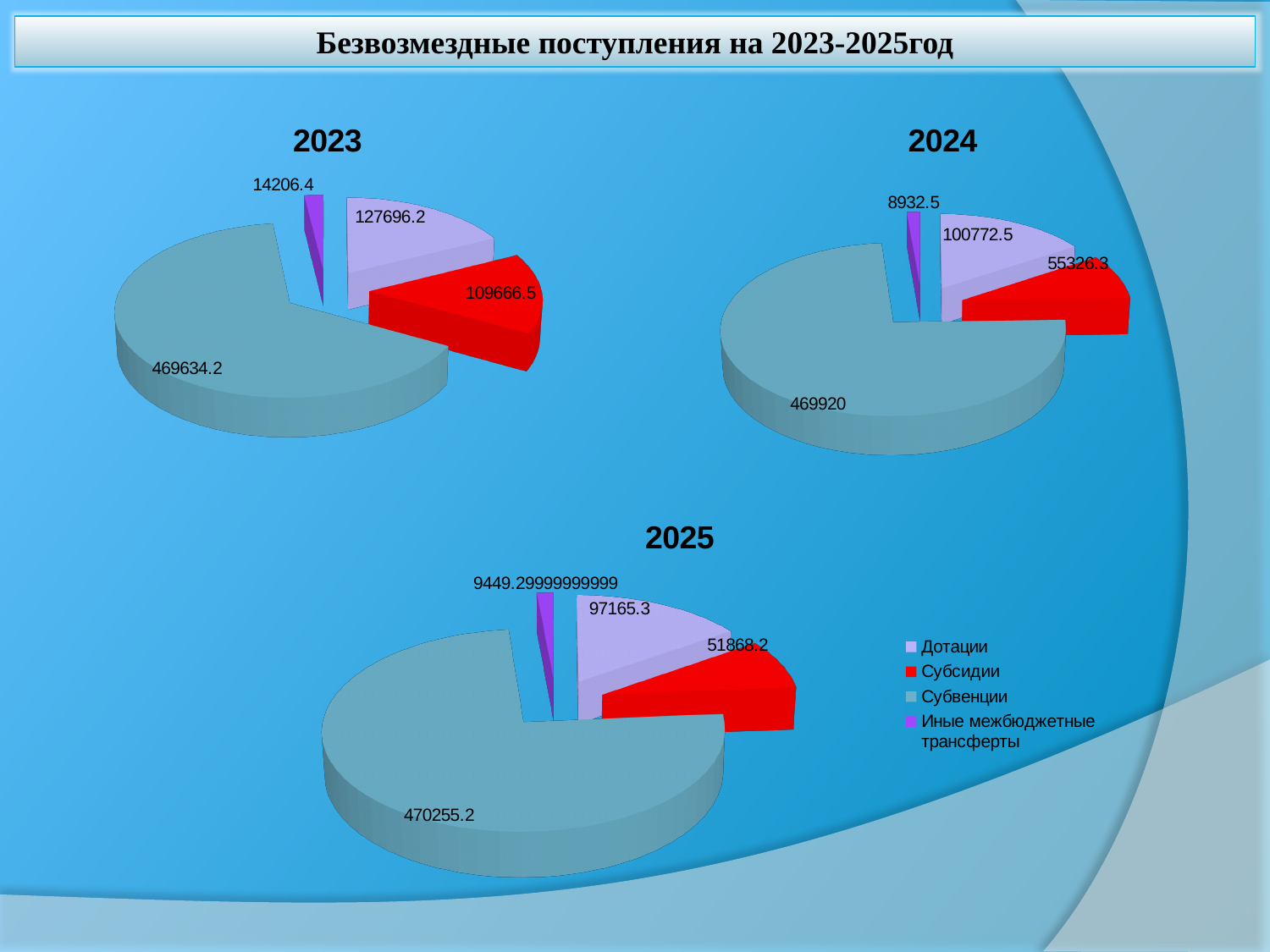
What type of chart is used for 2023, 2024 and 2025? Pie chart How many entries does the legend list? 4 In the 2023 pie chart, what is the value for Субсидии? 109666.5 In the 2023 pie chart, what is the difference between the values for Дотации and Субсидии? 18029.7 In the 2024 pie chart, which category has the largest value? Субвенции In the 2025 pie chart, what is the value for Иные межбюджетные трансферты? 9449.29999999999 In the 2025 pie chart, which is larger, Дотации or Субсидии? Дотации How many slices does the 2025 pie chart have? 4 In the 2024 pie chart, what is the value for Дотации? 100772.5 In the 2024 pie chart, what is the difference between the values for Дотации and Субсидии? 45446.2 In the 2023 pie chart, what is the value for Субвенции? 469634.2 In the 2023 pie chart, which category has the smallest value? Иные межбюджетные трансферты